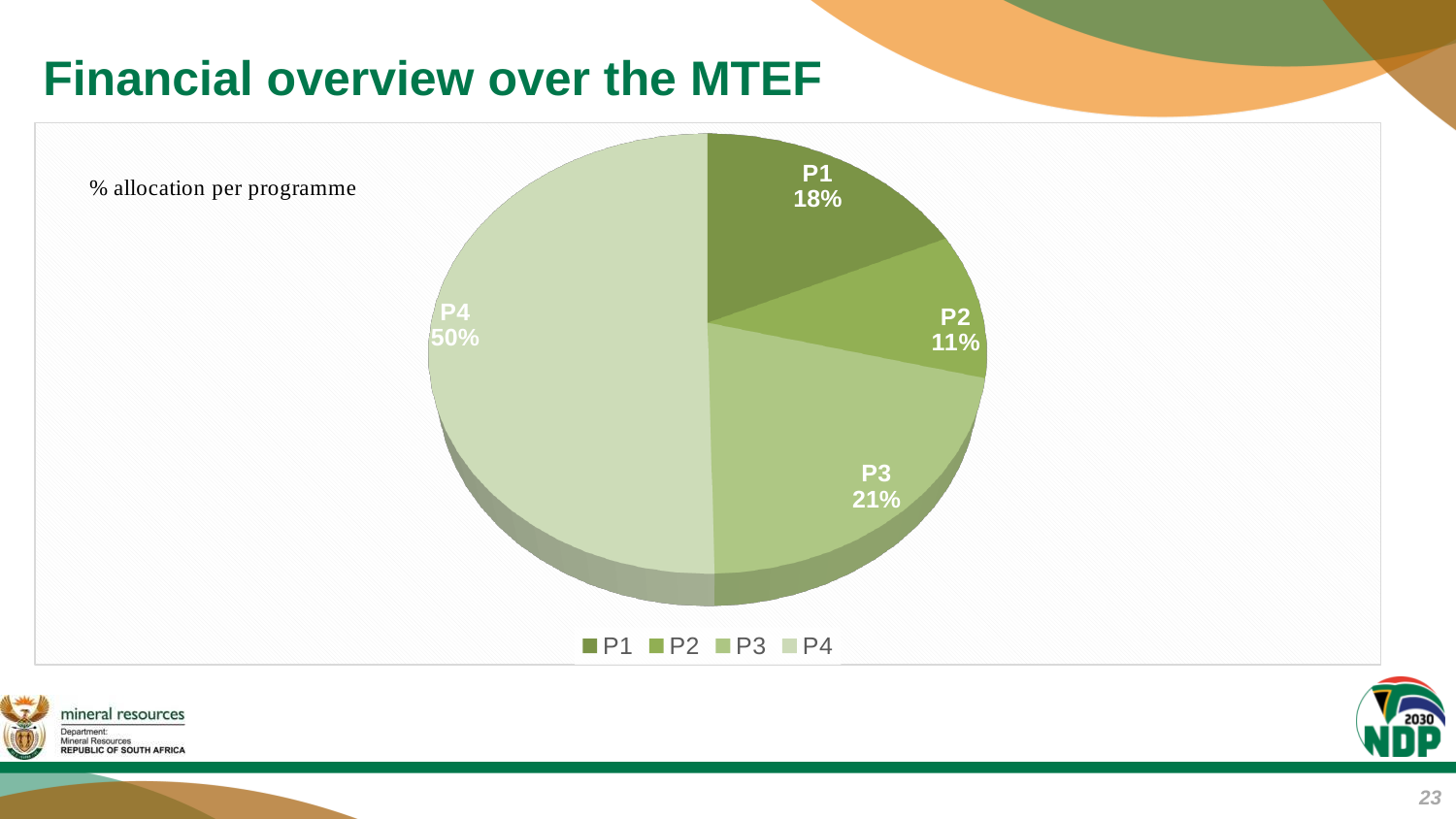
What kind of chart is shown on the slide? Pie chart Which has a larger share of the allocation, P1 or P3? P3 What percentage of the allocation goes to P2? 11% What is the combined share of P1 and P2? 29% What percentage of the allocation goes to P1? 18% Which programme has the smallest share of the allocation? P2 Which programme has the largest share of the allocation? P4 What percentage of the allocation goes to P3? 21% What is the difference in percentage points between the P4 and P3 shares? 29 What is the title of the chart? % allocation per programme How many programmes are shown in the pie chart? 4 What percentage of the allocation goes to P4? 50%